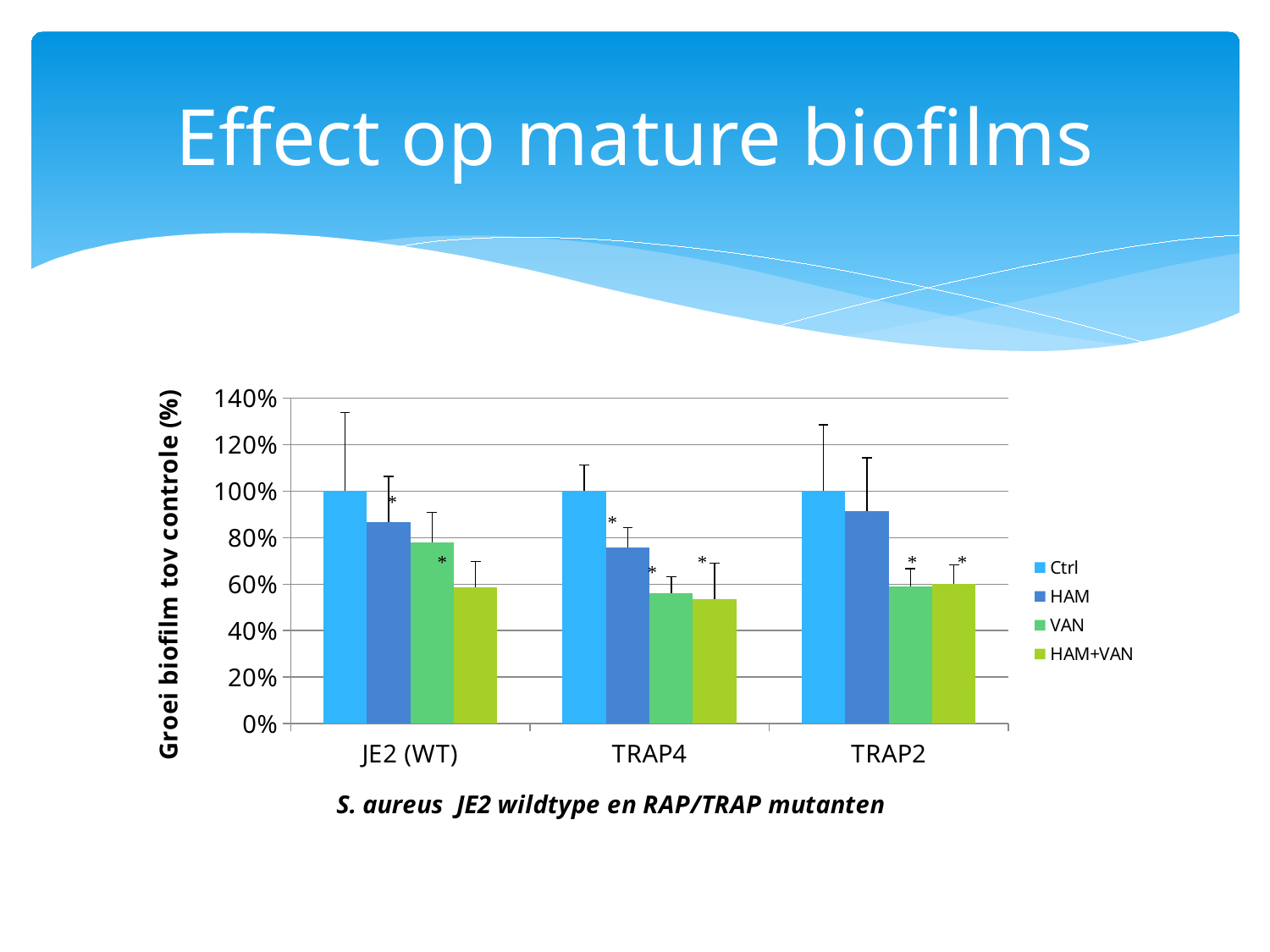
What is the value of the Ctrl bar for TRAP2? 100% Which series has the highest bar in the TRAP4 group? Ctrl Is the VAN value for TRAP2 greater or less than 80%? less How many series does the legend list? 4 How many strain categories are shown on the x axis? 3 What is the value of the Ctrl bar for JE2 (WT)? 100% Which is larger, the HAM bar for TRAP2 or the HAM bar for TRAP4? TRAP2 What is the title of the y axis? Groei biofilm tov controle (%) Is the HAM+VAN value for TRAP4 greater or less than 60%? less Which series has the lowest bar in the JE2 (WT) group? HAM+VAN What kind of chart is shown on the slide? bar chart Is the HAM value for JE2 (WT) greater or less than 80%? greater